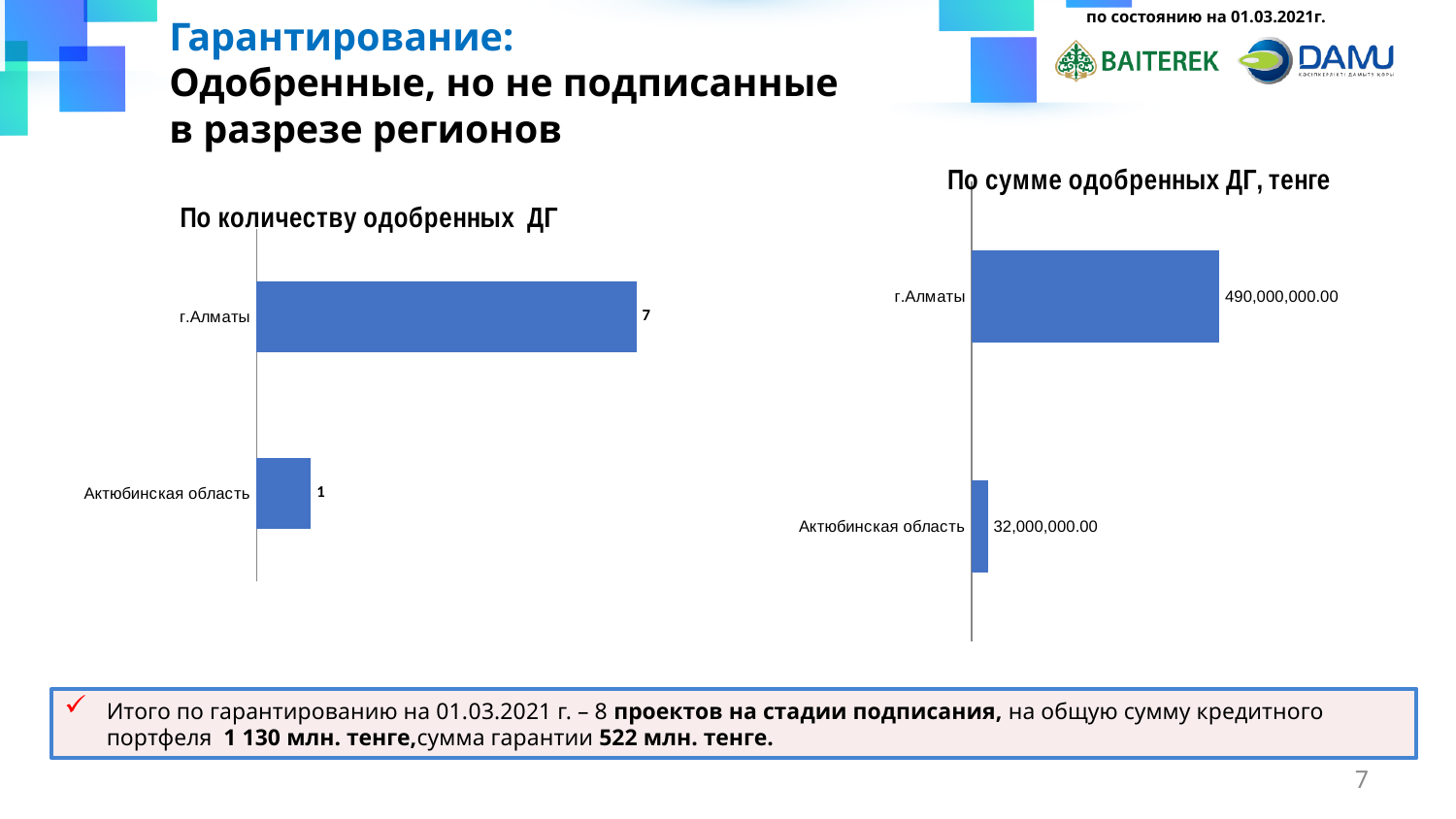
In the chart 'По сумме одобренных ДГ, тенге', which region has the lowest value? Актюбинская область In the chart 'По сумме одобренных ДГ, тенге', what is the difference between the values for г.Алматы and Актюбинская область? 458,000,000.00 What is the total of the values in the chart 'По количеству одобренных ДГ'? 8 How many regions are shown in the chart 'По количеству одобренных ДГ'? 2 In the chart 'По количеству одобренных ДГ', which region has the highest value? г.Алматы In the chart 'По сумме одобренных ДГ, тенге', what is the value for г.Алматы? 490,000,000.00 In the chart 'По количеству одобренных ДГ', what is the difference between the values for г.Алматы and Актюбинская область? 6 In the chart 'По количеству одобренных ДГ', what is the value for г.Алматы? 7 In the chart 'По количеству одобренных ДГ', what is the value for Актюбинская область? 1 What kind of chart is 'По сумме одобренных ДГ, тенге'? bar chart In the chart 'По сумме одобренных ДГ, тенге', which is larger: the value for г.Алматы or for Актюбинская область? г.Алматы In the chart 'По сумме одобренных ДГ, тенге', what is the value for Актюбинская область? 32,000,000.00